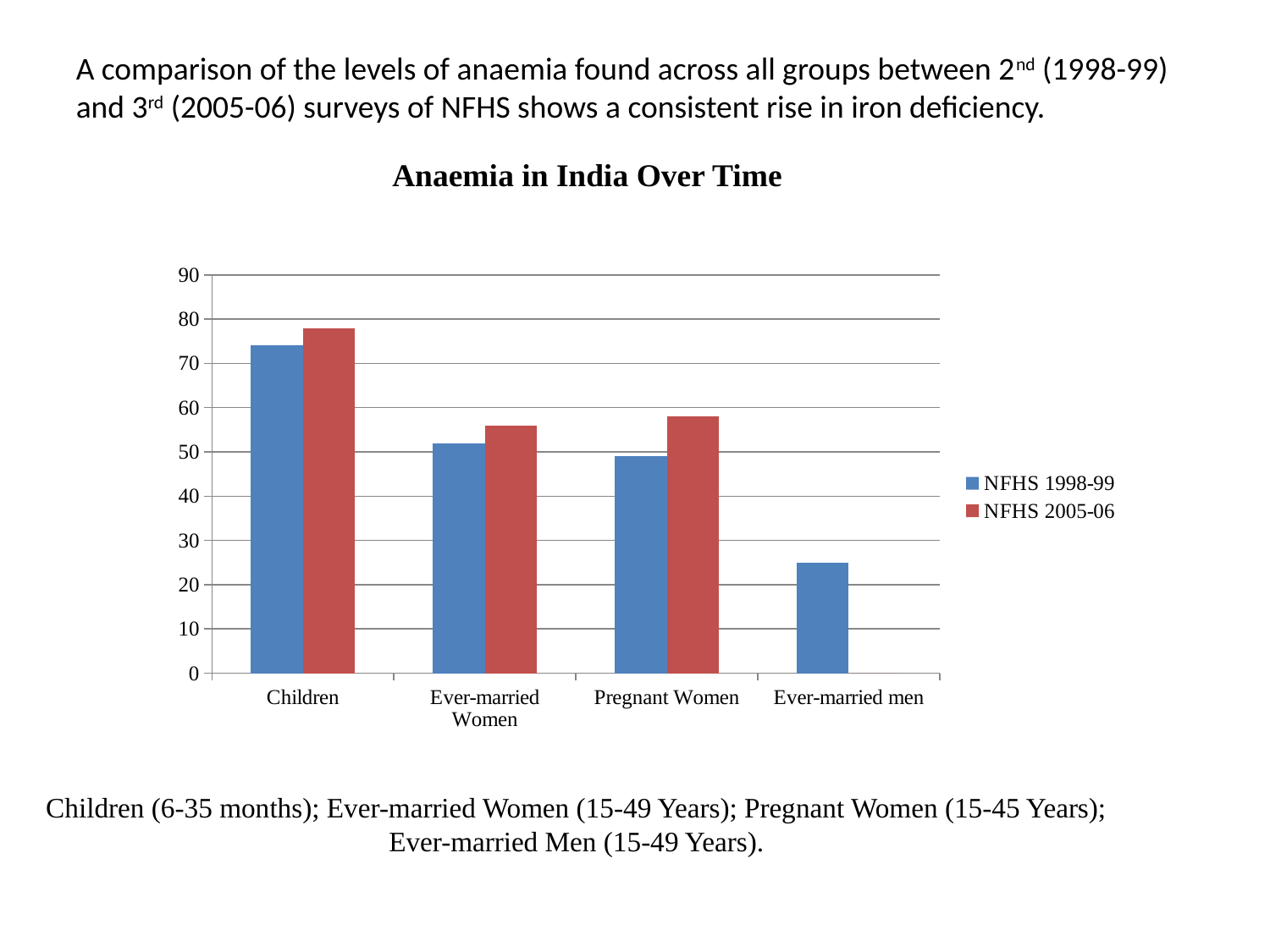
Which category has the highest value for NFHS 2005-06? Children Which category has the highest value for NFHS 1998-99? Children For Pregnant Women, which series has the larger value, NFHS 1998-99 or NFHS 2005-06? NFHS 2005-06 Is the NFHS 1998-99 value for Ever-married men greater or less than 30? less Is the NFHS 2005-06 value for Pregnant Women greater or less than 50? greater How many categories are shown on the x axis? 4 What is the title of the chart? Anaemia in India Over Time Which category has no bar for the NFHS 2005-06 series? Ever-married men How many series does the legend list? 2 What kind of chart is shown on the slide? bar chart Is the NFHS 1998-99 value for Children greater or less than 70? greater Which category has the lowest value for NFHS 1998-99? Ever-married men